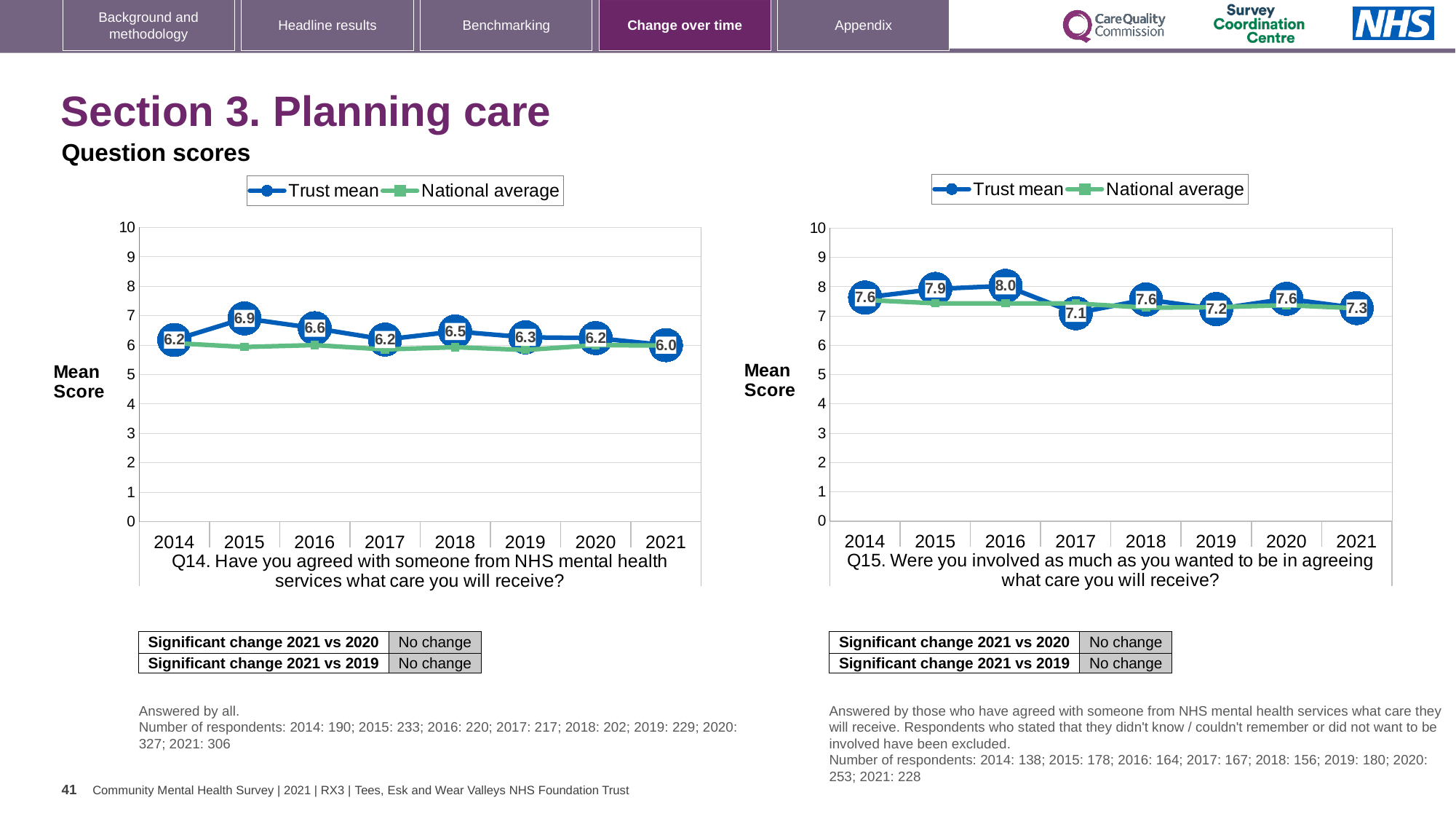
In the Q14 chart on the left, which year has the highest Trust mean? 2015 How many series does the legend of the Q15 chart on the right list? 2 In the Q15 chart on the right, is the National average for 2014 greater or less than 7? greater How many years are plotted on the x axis of the Q14 chart on the left? 8 In the Q15 chart on the right, what is the difference between the Trust mean in 2016 and in 2017? 0.9 In the Q14 chart on the left, what is the difference between the Trust mean in 2015 and in 2021? 0.9 In the Q14 chart on the left, which year has the lowest Trust mean? 2021 In the Q14 chart on the left, what is the Trust mean for 2015? 6.9 In the Q15 chart on the right, is the Trust mean higher in 2015 or in 2019? 2015 In the Q15 chart on the right, which year has the lowest Trust mean? 2017 In the Q14 chart on the left, what is the Trust mean for 2021? 6.0 In the Q15 chart on the right, what is the Trust mean for 2016? 8.0